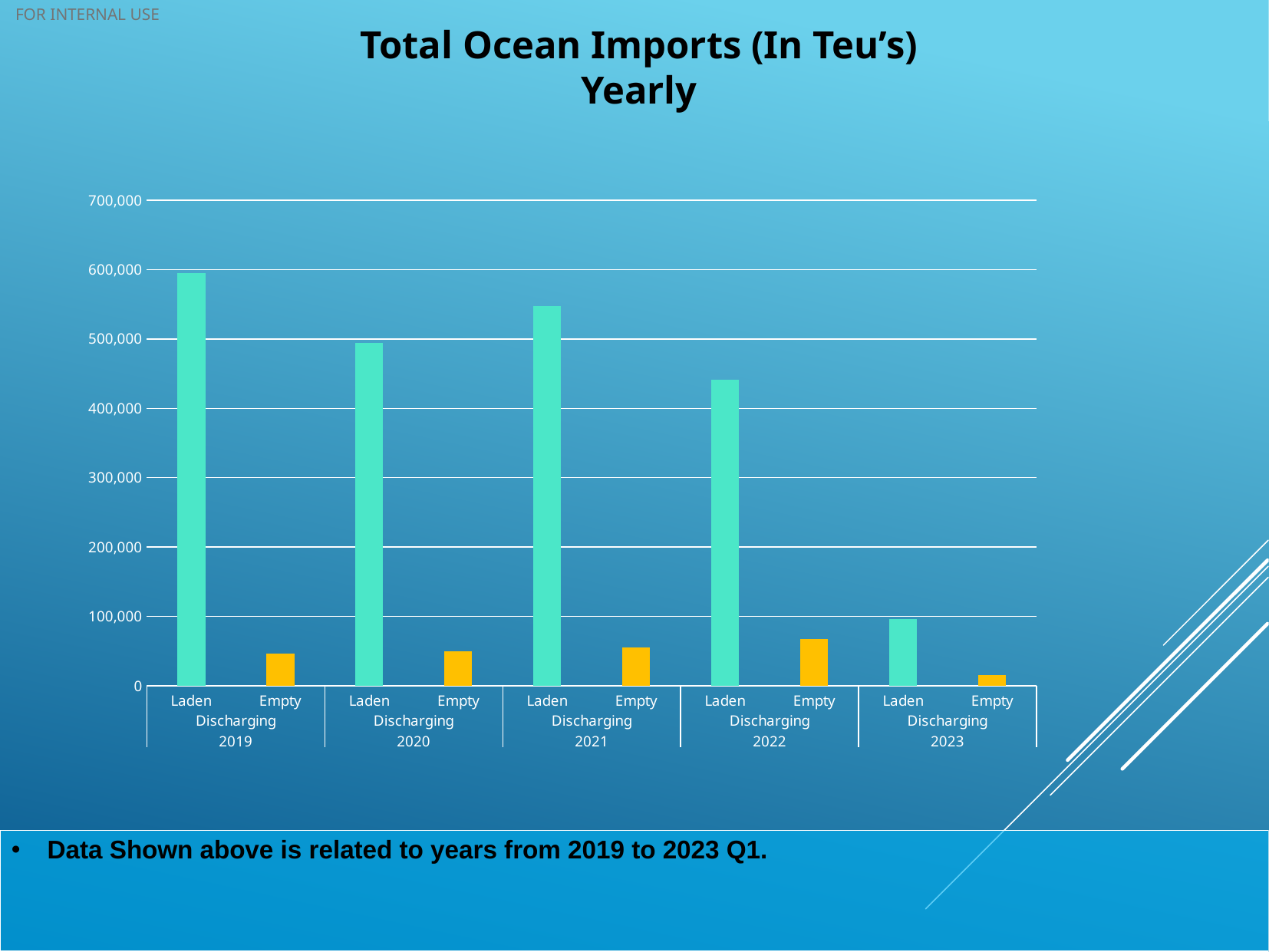
Which is larger, Laden Discharging in 2019 or Laden Discharging in 2021? Laden Discharging in 2019 Which bar is the lowest in the chart? Empty 2023 Is the value for Empty in 2022 greater or less than 100,000? less Is the value for Laden Discharging in 2021 greater or less than 500,000? greater From 2021 to 2023, do the Laden Discharging values rise or fall? fall Which year has the highest Laden Discharging value? 2019 Is the value for Laden Discharging in 2022 greater or less than 400,000? greater Which is larger, the Empty value in 2019 or the Empty value in 2022? Empty in 2022 How many years are shown along the x axis of the chart? 5 What kind of chart is shown on the slide? Bar chart What is the title of the chart? Total Ocean Imports (In Teu's) Yearly How many bars are plotted in the chart in total? 10